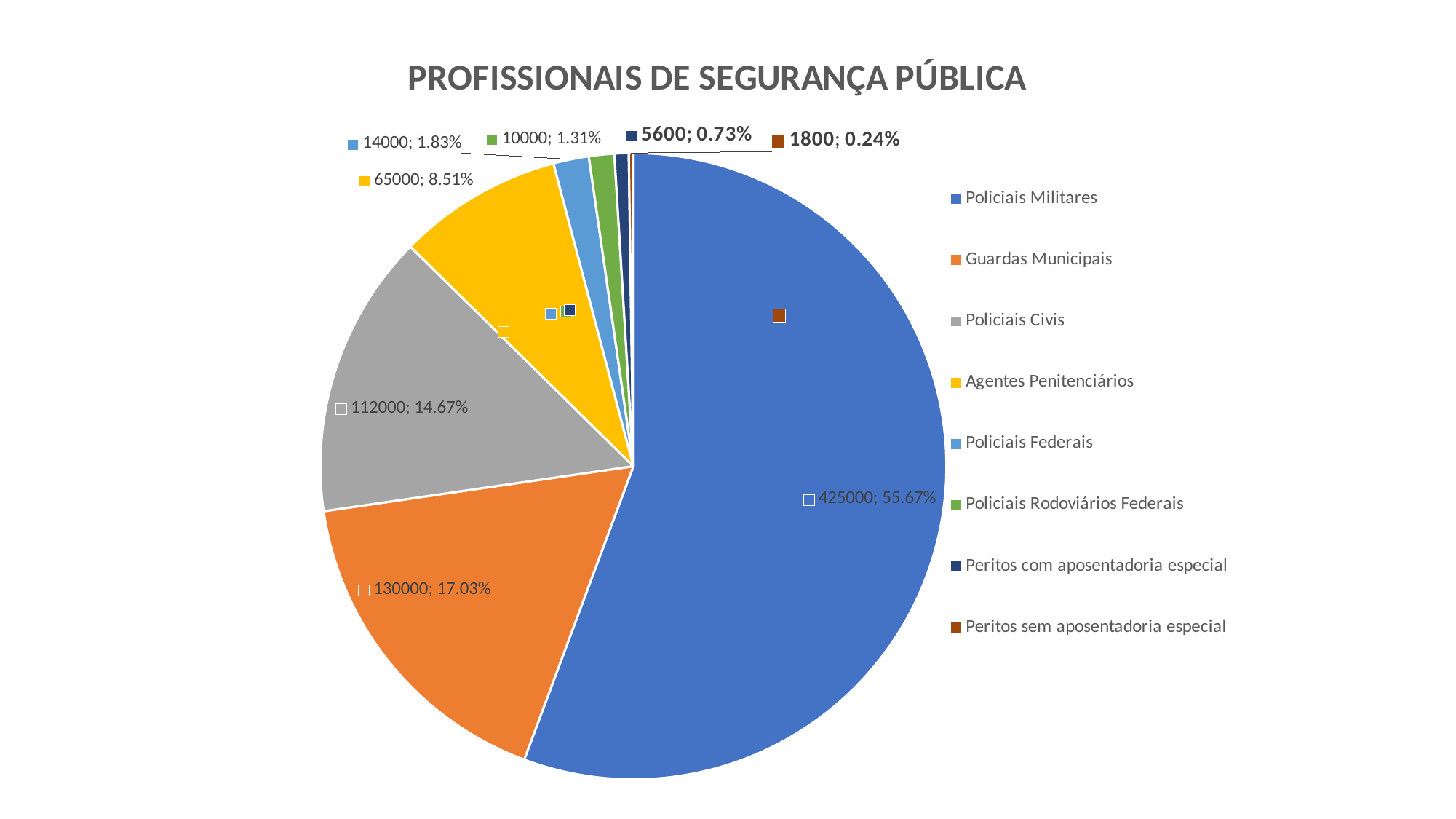
Which category has the largest slice? Policiais Militares What share of the pie does Guardas Municipais represent? 17.03% What is the value for Policiais Civis? 112000 What is the value for Policiais Militares? 425000 What is the difference between the values for Guardas Municipais and Policiais Civis? 18000 Which is larger, the value for Policiais Federais or the value for Policiais Rodoviários Federais? Policiais Federais What type of chart is shown on the slide? pie chart What is the value for Peritos com aposentadoria especial? 5600 What share of the pie does Agentes Penitenciários represent? 8.51% How many categories does the pie chart have? 8 Which category has the smallest slice? Peritos sem aposentadoria especial What is the title of the chart? PROFISSIONAIS DE SEGURANÇA PÚBLICA